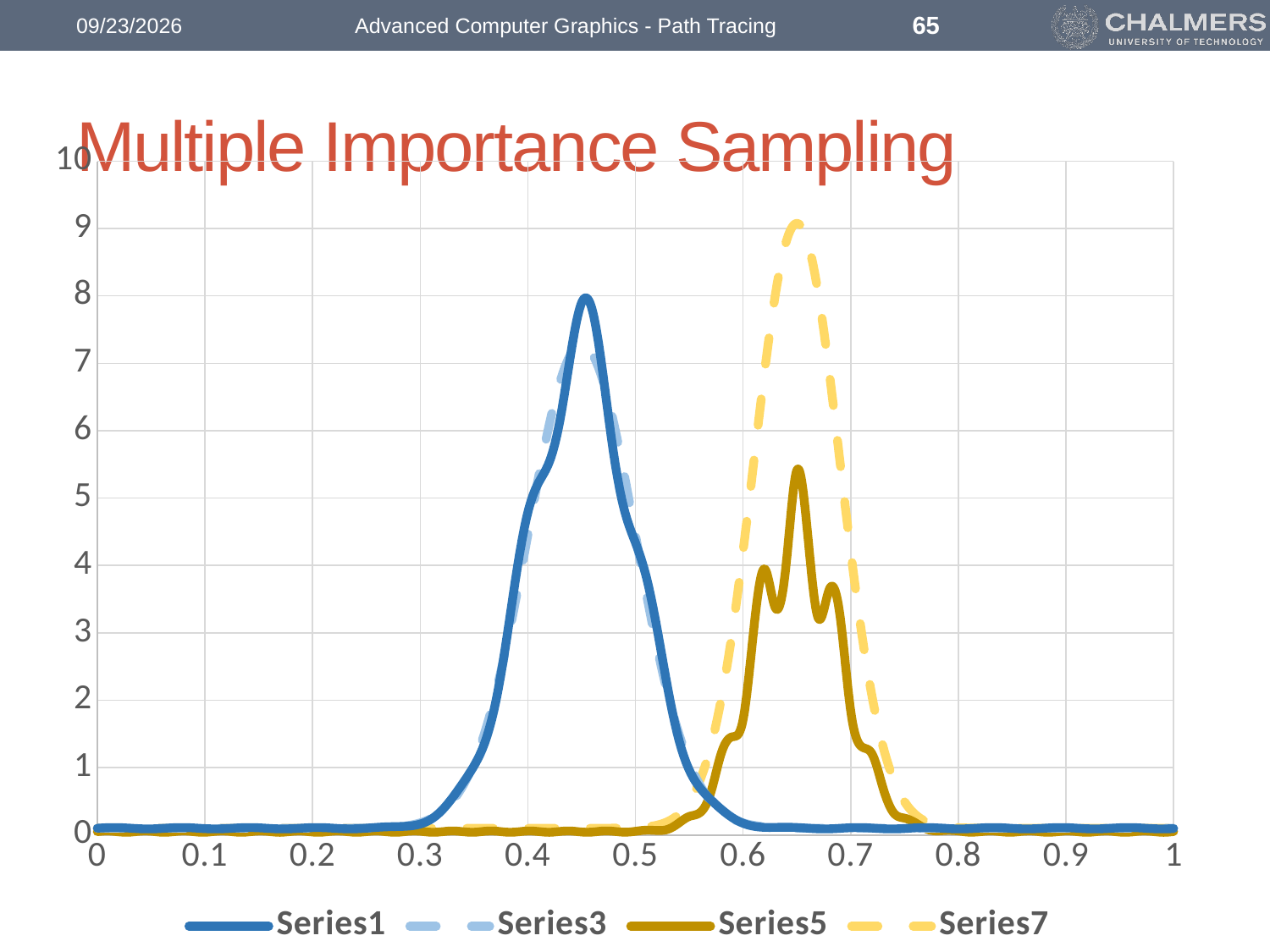
Which series has the lowest peak value? Series5 Is the peak value of Series5 greater or less than 6? less How many series does the legend list? 4 Which series reaches the highest peak value? Series7 Is the peak value of Series7 greater or less than 8? greater Which has a higher peak, Series1 or Series7? Series7 Is the value of Series1 at x = 0.2 greater or less than 1? less What kind of chart is shown on the slide? line chart Which series are drawn with dashed lines? Series3 and Series7 Which has a higher peak, Series1 or Series5? Series1